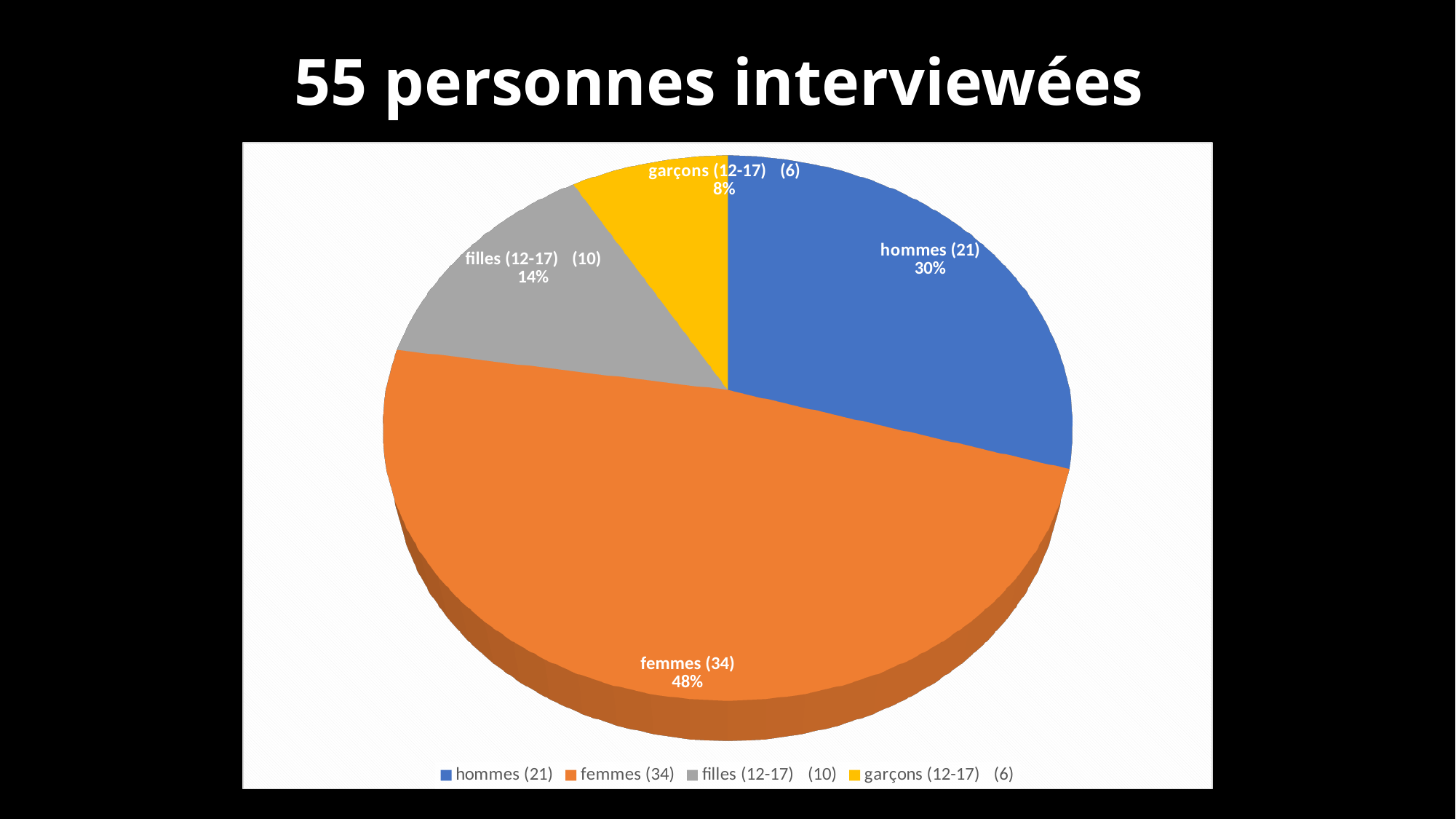
What is the title of the chart? 55 personnes interviewées What percentage share does the 'filles (12-17) (10)' slice have? 14% Which category has the smallest slice of the pie? garçons (12-17) (6) What percentage share does the 'garçons (12-17) (6)' slice have? 8% Which slice is larger, 'hommes (21)' or 'filles (12-17) (10)'? hommes (21) How many slices does the pie chart have? 4 What percentage share does the 'femmes (34)' slice have? 48% Which category has the largest slice of the pie? femmes (34) What kind of chart is shown on the slide? pie chart What is the difference in percentage points between the 'femmes (34)' slice and the 'hommes (21)' slice? 18% What colour is the 'femmes (34)' slice? orange